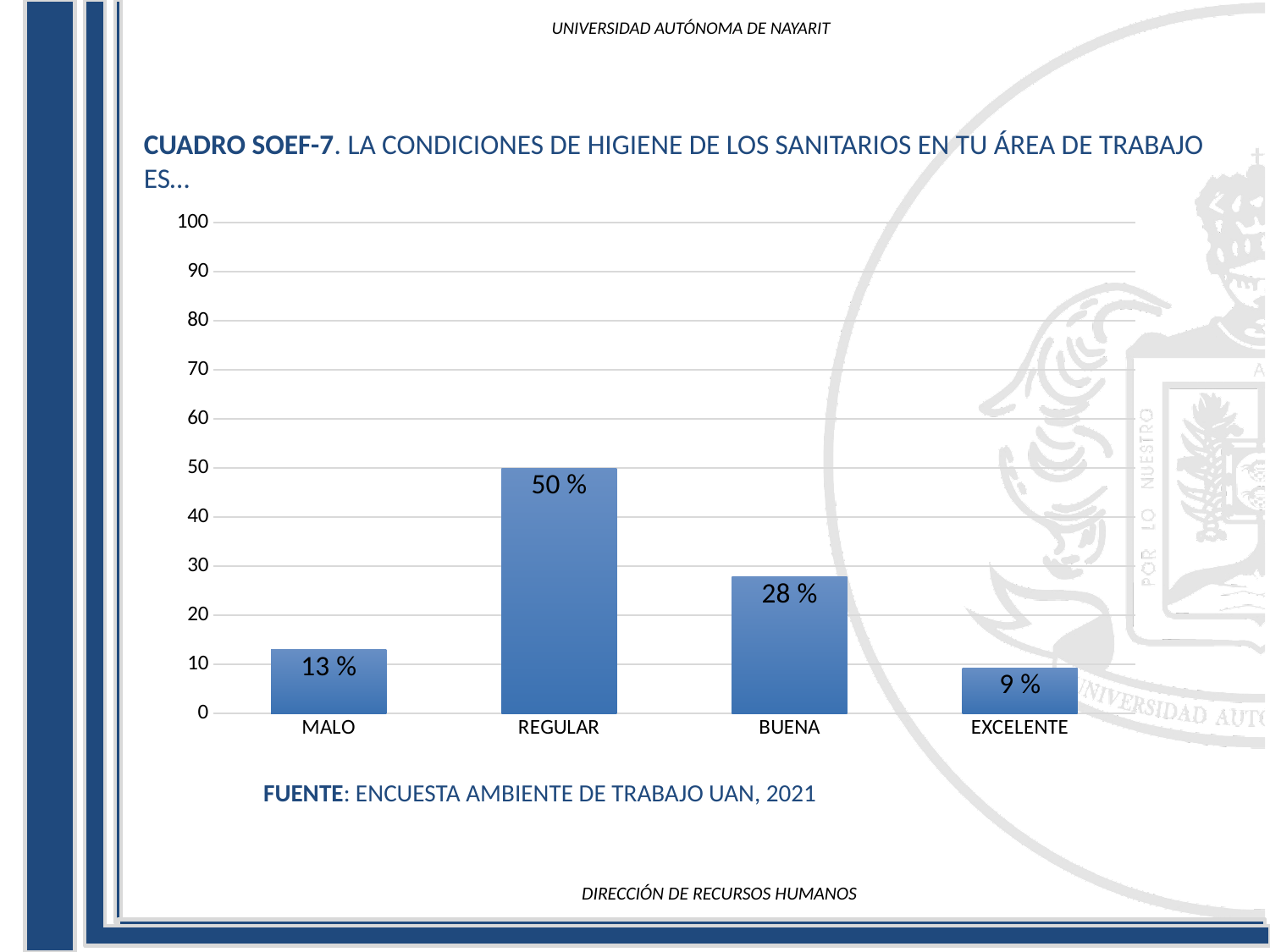
What is the source cited below the chart? ENCUESTA AMBIENTE DE TRABAJO UAN, 2021 What is the difference between the values for MALO and EXCELENTE? 4 % Is the value for BUENA greater or less than 30? less Which category has the lowest value? EXCELENTE What is the value for MALO? 13 % What is the value for EXCELENTE? 9 % What kind of chart is shown on the slide? bar chart How many categories are shown on the x axis? 4 Which category has the highest value? REGULAR What is the value for REGULAR? 50 % Which is larger, the value for MALO or the value for BUENA? BUENA What is the difference between the values for REGULAR and BUENA? 22 %